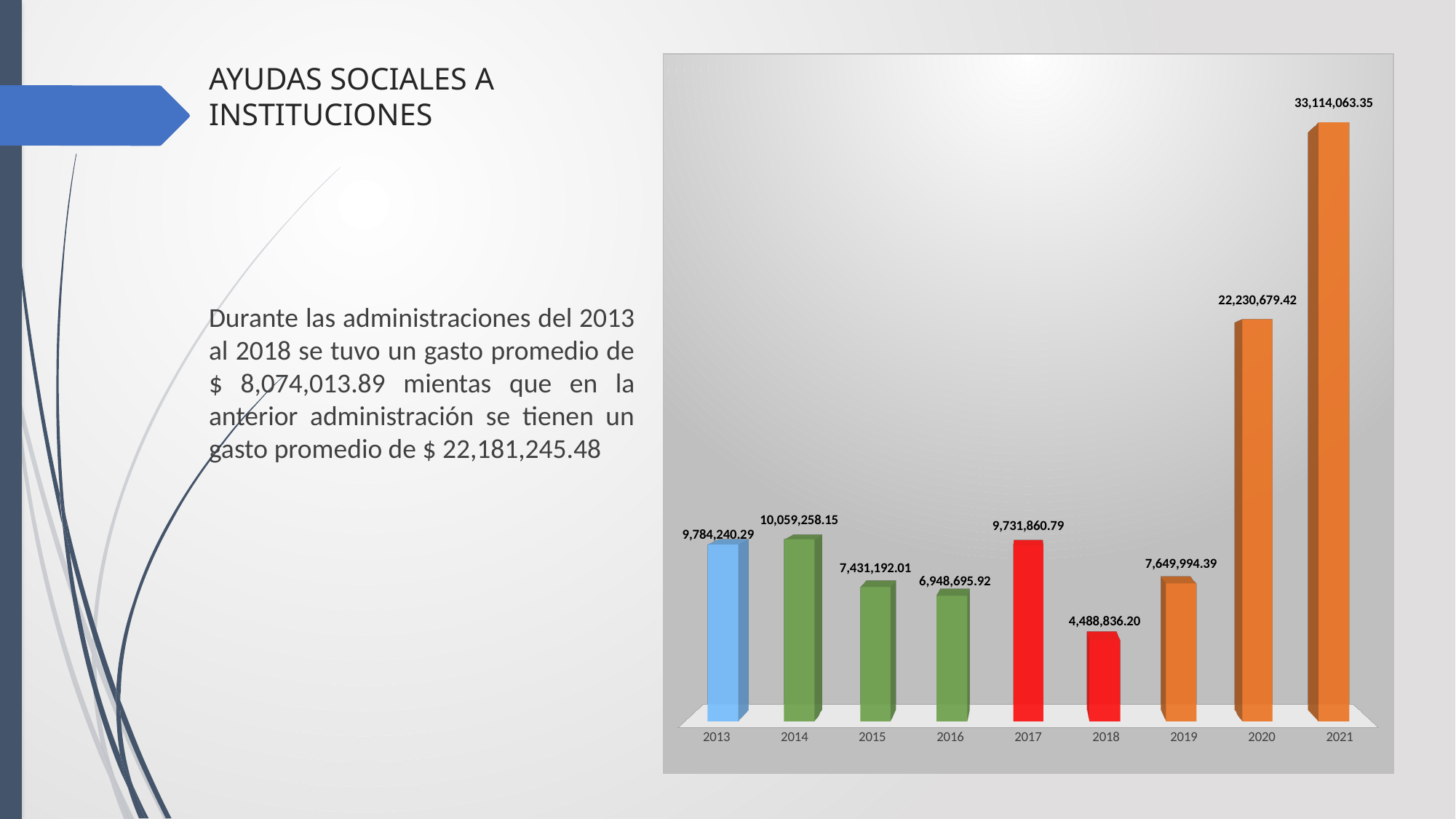
What is the value for 2018? 4,488,836.20 Which year has the lowest value? 2018 What is the value for 2020? 22,230,679.42 What is the difference between the values for 2014 and 2013? 275,017.86 Do the values rise or fall from 2018 to 2021? Rise Which year has the highest value? 2021 Which is larger, the value for 2017 or the value for 2019? 2017 What kind of chart is shown? Bar chart What is the value for 2015? 7,431,192.01 How many years are shown on the x axis? 9 What is the value for 2021? 33,114,063.35 What is the difference between the values for 2021 and 2020? 10,883,383.93